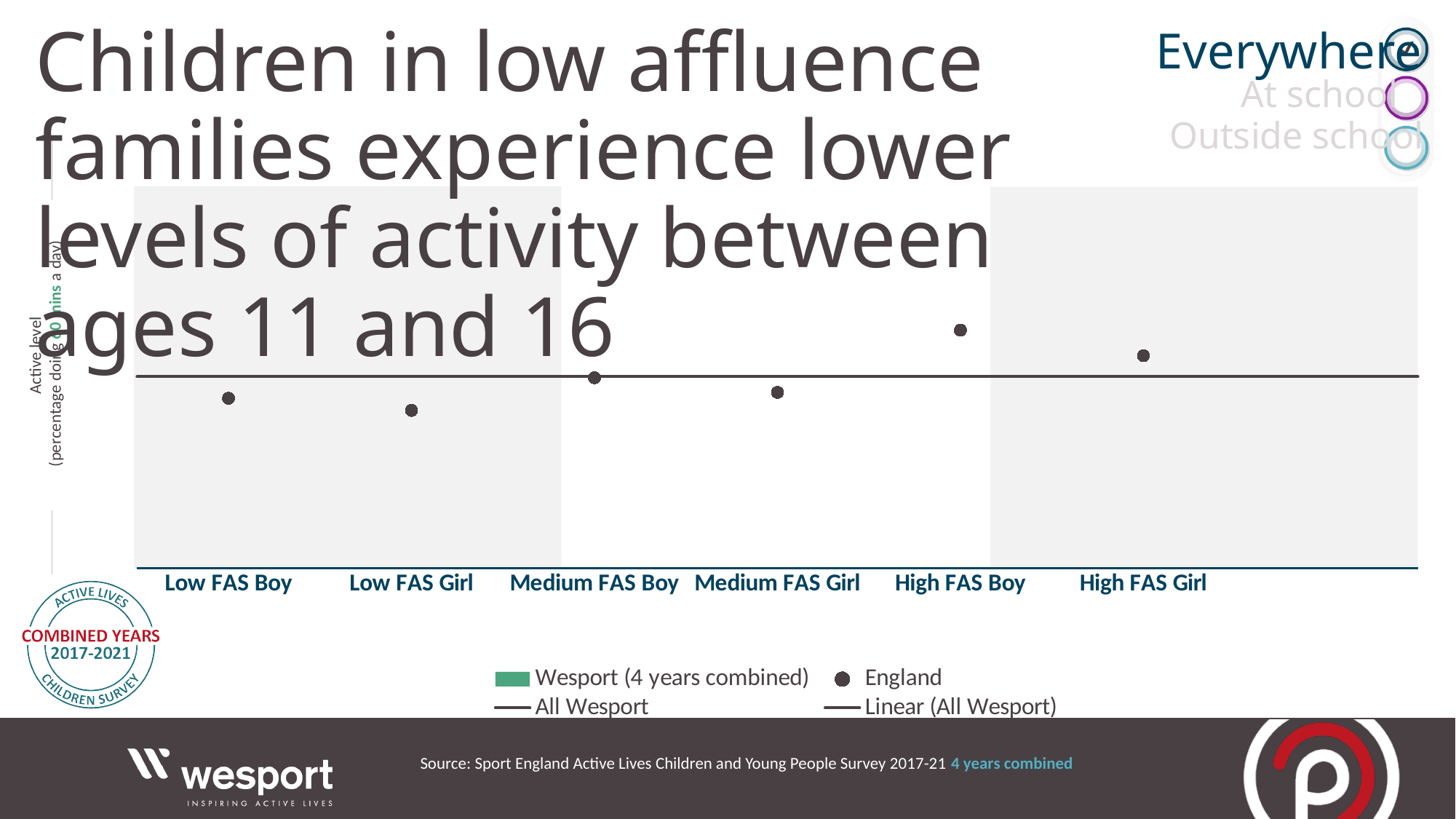
How many series does the chart legend list? 4 Is the England value higher for High FAS Boy or for Low FAS Girl? High FAS Boy Which two categories have England values clearly above the All Wesport line? High FAS Boy and High FAS Girl How many categories are shown along the x axis of the chart? 6 Is the England value higher for Medium FAS Boy or for Medium FAS Girl? Medium FAS Boy What is the first entry listed in the chart legend? Wesport (4 years combined) Which category has the highest England value? High FAS Boy What is the label of the x-axis category between Low FAS Girl and Medium FAS Girl? Medium FAS Boy Do the England values generally rise or fall moving from the Low FAS categories to the High FAS categories? rise Which category has the lowest England value? Low FAS Girl